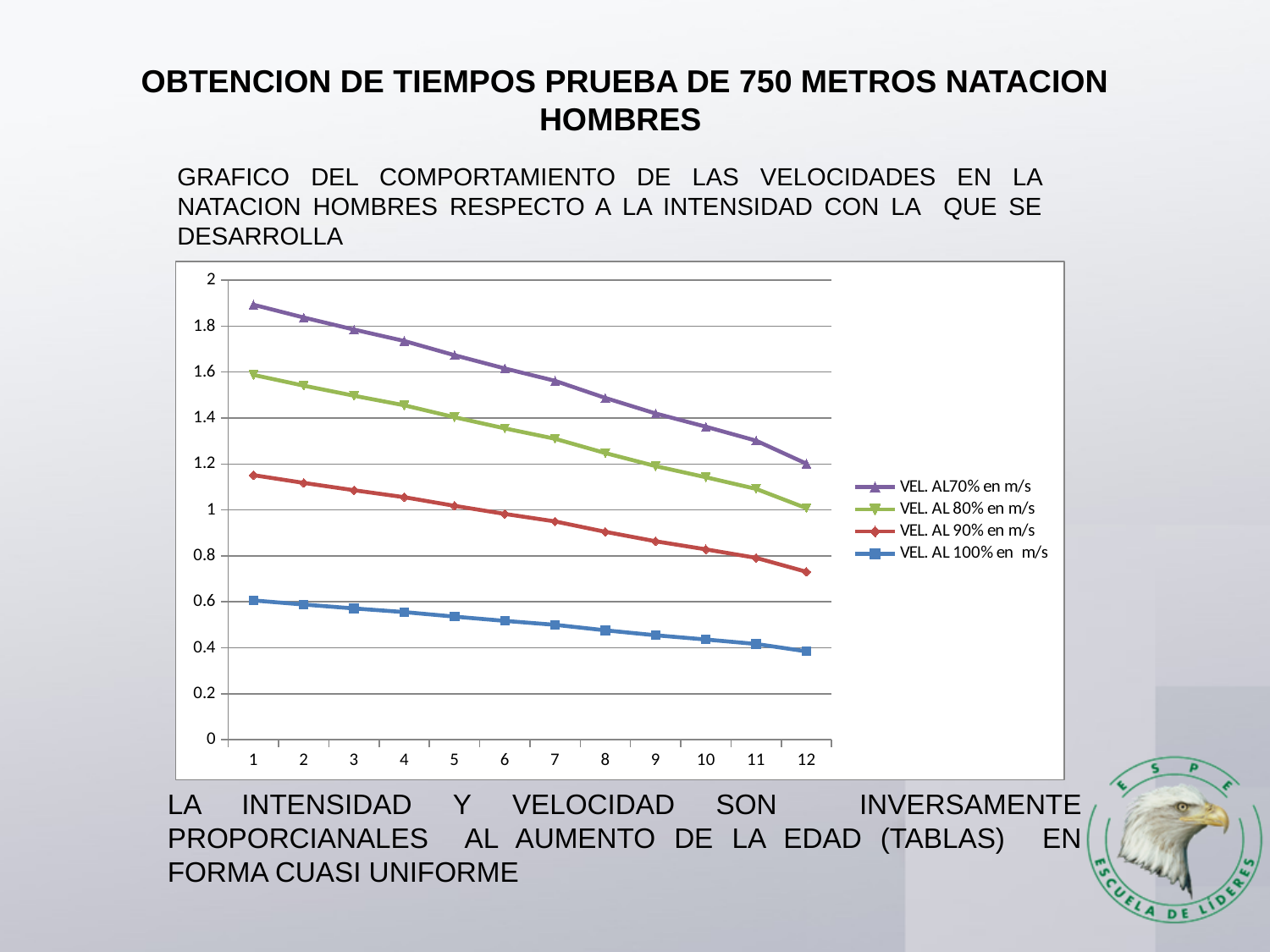
Which series has the highest values across the chart? VEL. AL70% en m/s What kind of chart is shown on the slide? line chart What colour is the line for VEL. AL 100% en m/s? blue How many points are plotted along the x axis for each series? 12 Is the value for VEL. AL70% en m/s at x = 1 greater or less than 1.8? greater Is the value for VEL. AL 90% en m/s at x = 12 greater or less than 0.8? less Do the values of the VEL. AL 90% en m/s series rise or fall as the x axis goes from 1 to 12? fall Is the value for VEL. AL 100% en m/s at x = 6 greater or less than 0.4? greater How many series does the legend list? 4 Which series has the lowest values across the chart? VEL. AL 100% en m/s At x = 5, which is larger: the value for VEL. AL70% en m/s or the value for VEL. AL 100% en m/s? VEL. AL70% en m/s